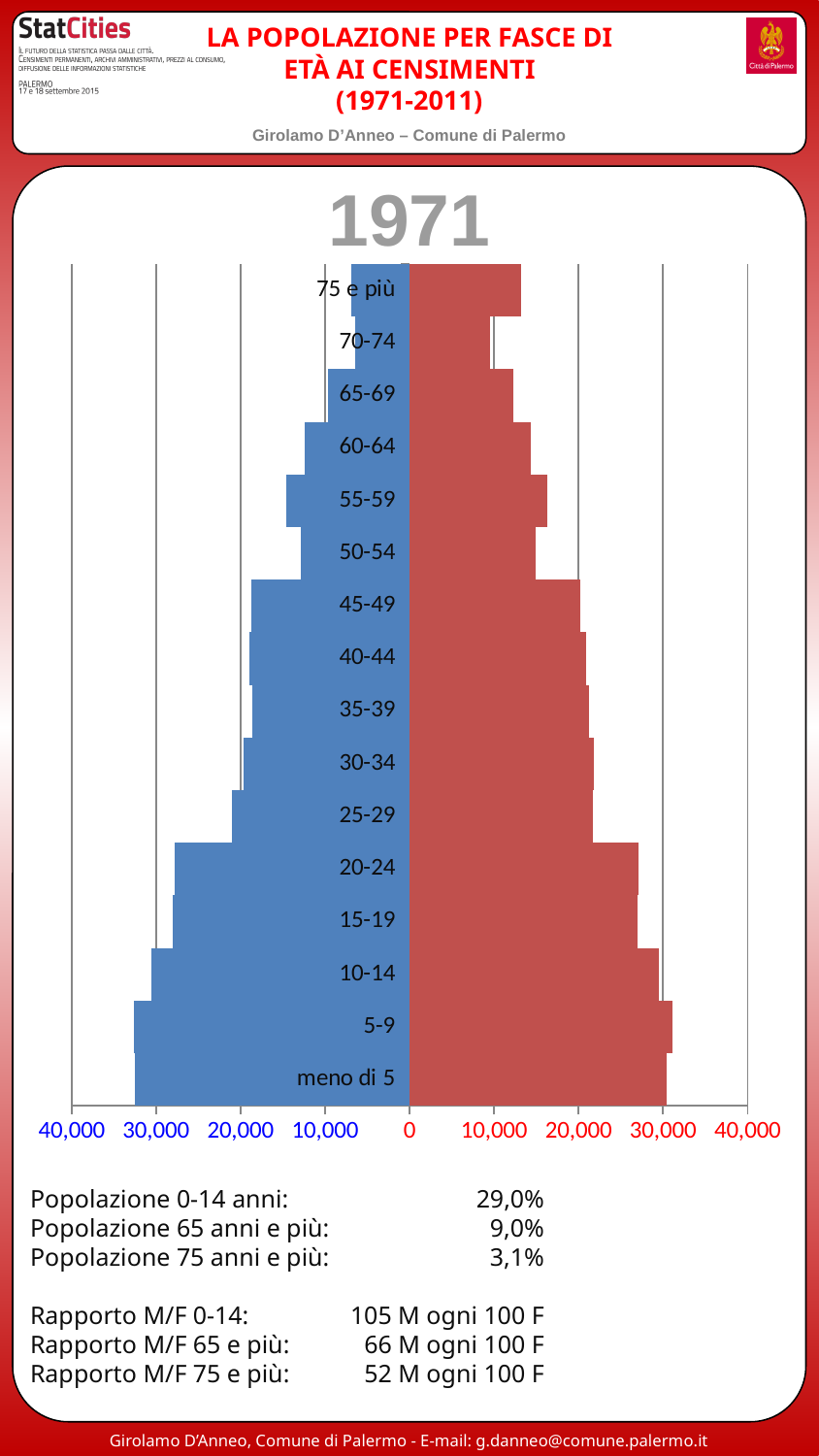
For the 75 e più age group, which bar is longer: the left (blue) bar or the right (red) bar? the right (red) bar What kind of chart is shown on the slide? bar chart (population pyramid) Is the value of the right (red) bar for the 60-64 age group greater or less than 20,000? less Is the value of the right (red) bar for the 75 e più age group greater or less than 10,000? greater Is the value of the left (blue) bar for the 75 e più age group greater or less than 10,000? less How many age groups are shown on the chart? 16 What year is shown as the title above the chart? 1971 What colour are the bars on the left side of the chart? blue Moving from the 75 e più group at the top down to the meno di 5 group at the bottom, do the bars generally get longer or shorter? longer